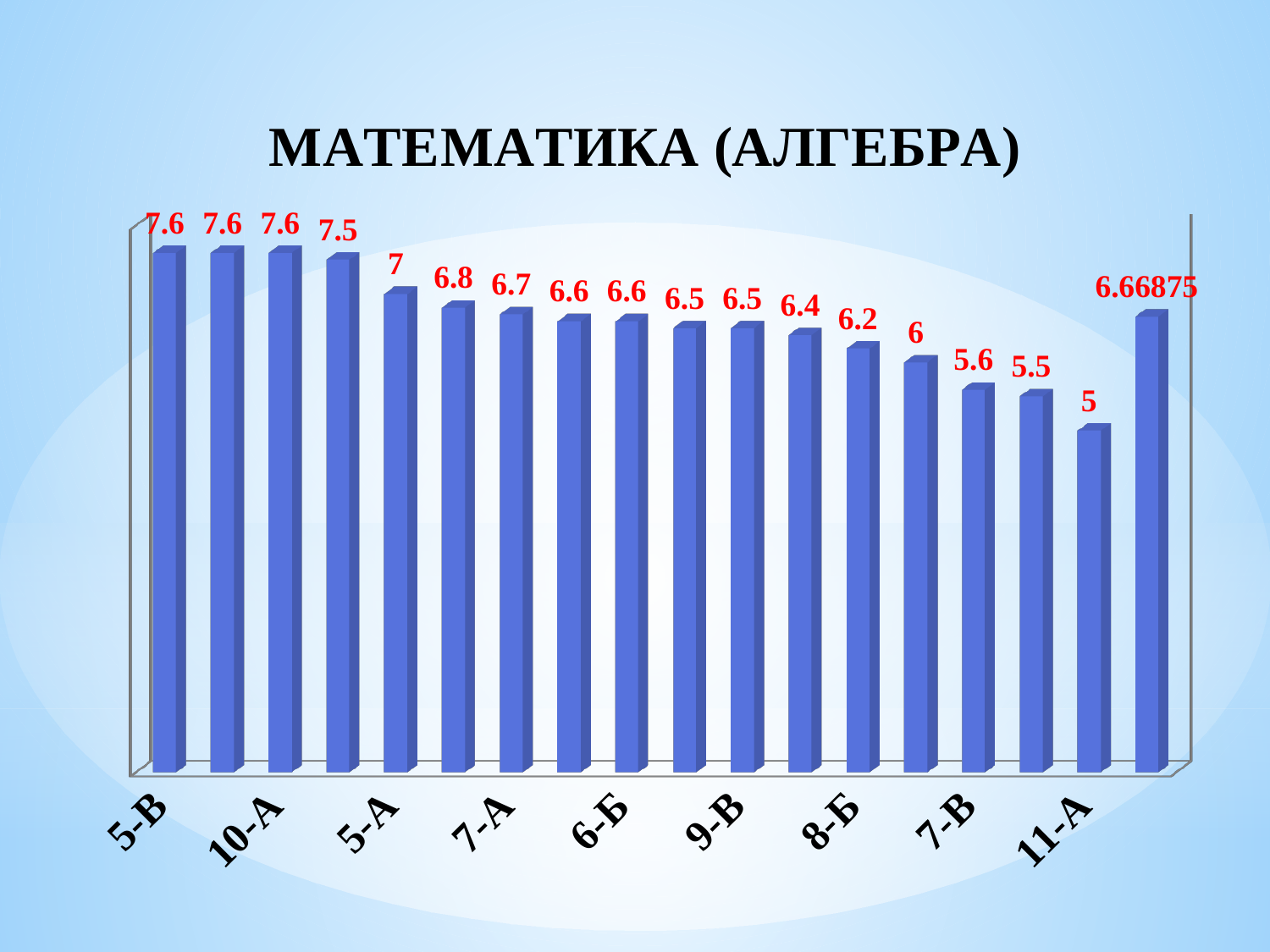
What is the value for 8-Б? 6.2 Which is larger, the value for 5-А or the value for 7-В? 5-А What is the title of the chart? МАТЕМАТИКА (АЛГЕБРА) What is the highest value shown on the chart? 7.6 What is the value for 7-А? 6.7 What is the difference between the values for 5-В and 11-А? 2.6 What is the value for 5-А? 7 What is the value for 5-В? 7.6 What is the value for 9-В? 6.5 Which labelled category has the lowest value? 11-А What is the value for 11-А? 5 What kind of chart is shown on the slide? bar chart